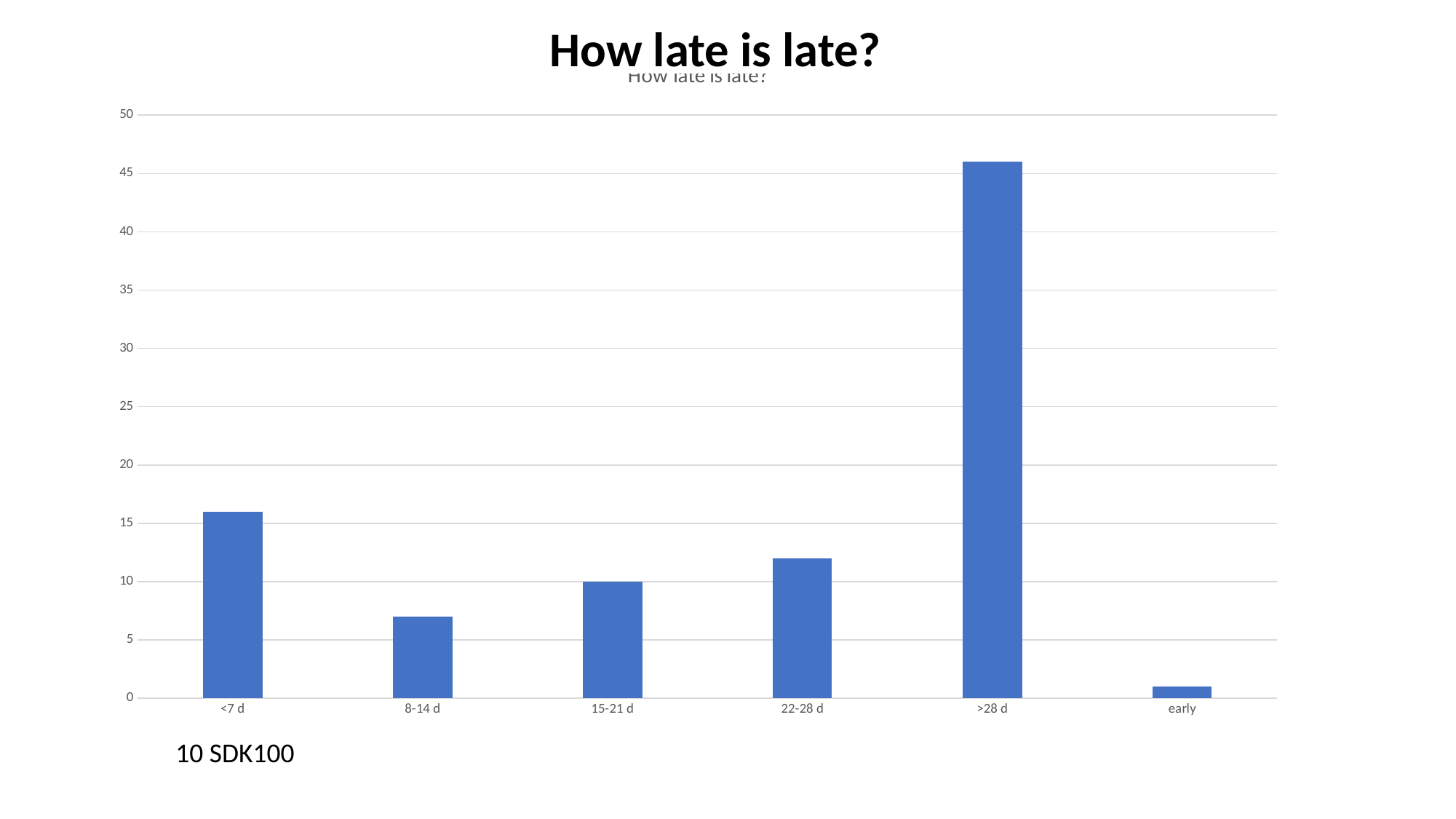
Is the value for 22-28 d greater or less than 10? greater What is the value for 15-21 d? 10 Which category has the lowest value? early What is the title of the chart? How late is late? Which has the larger value, <7 d or 22-28 d? <7 d Is the value for early greater or less than 5? less Is the value for <7 d greater or less than 20? less How many categories are shown on the x axis? 6 What kind of chart is shown on the slide? bar chart Which category has the highest value? >28 d